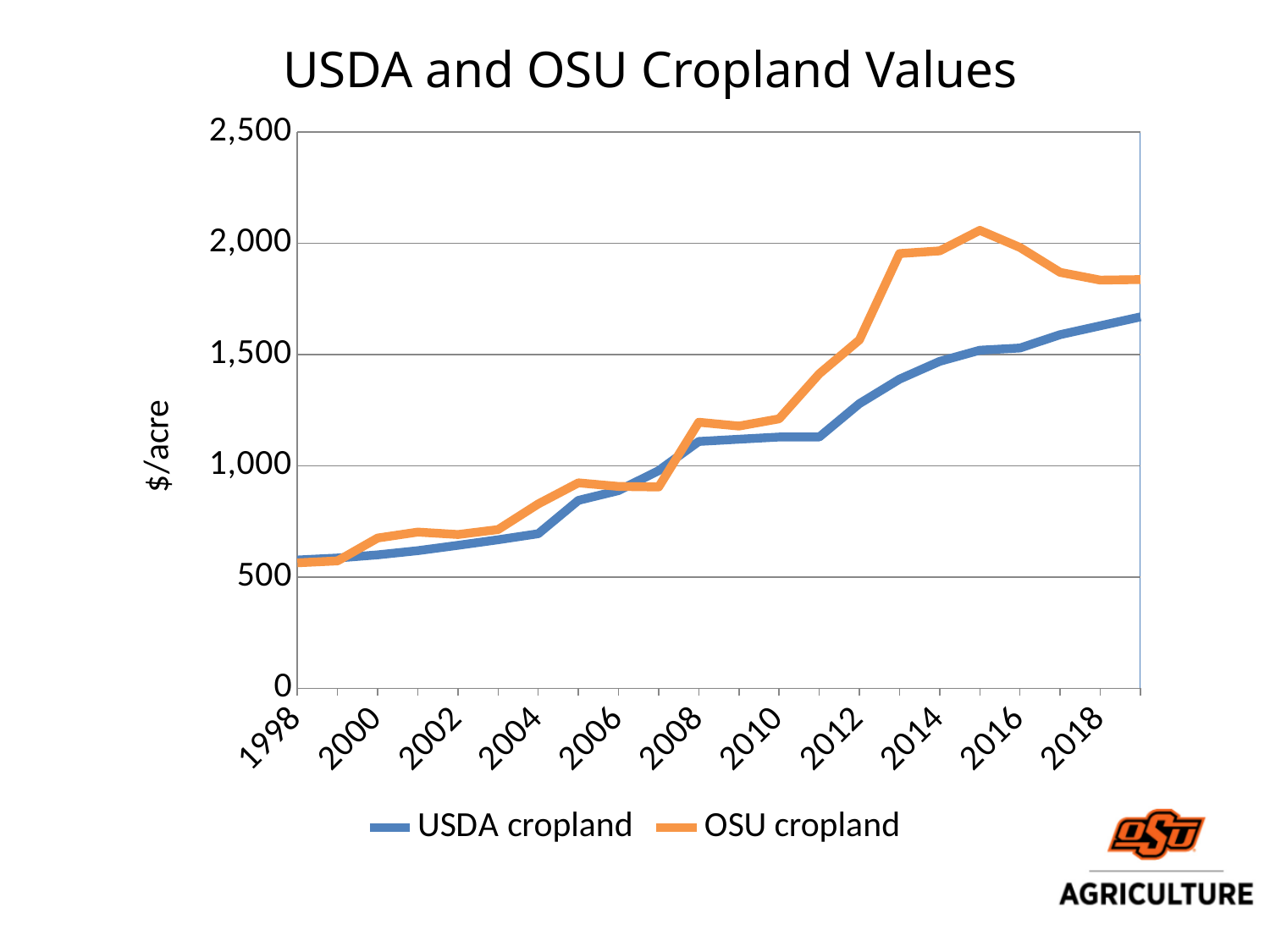
Is the value for USDA cropland in 2018 greater or less than 1,500? greater What is the label on the vertical axis? $/acre Is the value for OSU cropland in 2013 greater or less than 1,500? greater Does the USDA cropland line generally rise or fall from 1998 to the end of the series? rise Is the value for USDA cropland in 2010 greater or less than 1,500? less Does the OSU cropland line rise or fall between 2015 and 2018? fall How many year labels are shown on the horizontal axis? 11 What kind of chart is shown on the slide? line chart In 2014, which series has the higher value, USDA cropland or OSU cropland? OSU cropland What is the title of the chart? USDA and OSU Cropland Values How many series does the legend list? 2